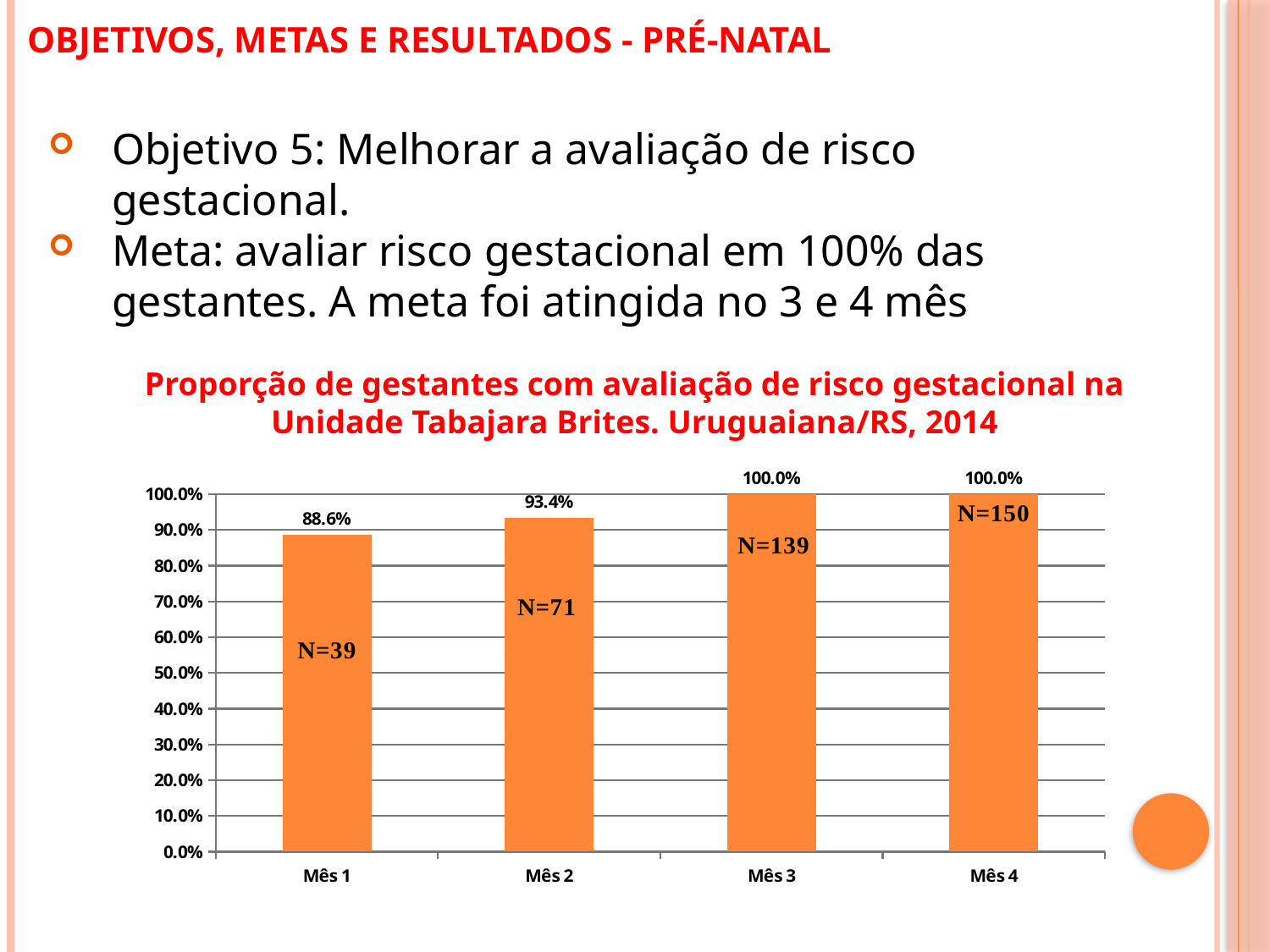
How many months are shown on the x axis? 4 Which is larger, the value for Mês 1 or the value for Mês 2? Mês 2 What is the value for Mês 3? 100.0% What is the value for Mês 2? 93.4% Is the value for Mês 1 greater or less than 80.0%? greater What N value is printed on the bar for Mês 3? N=139 What colour are the bars in the chart? orange What is the value for Mês 1? 88.6% What kind of chart is shown on the slide? bar chart Which month has the lowest value? Mês 1 What is the difference between the values for Mês 2 and Mês 1? 4.8% Do the values rise or fall from Mês 1 to Mês 4? rise